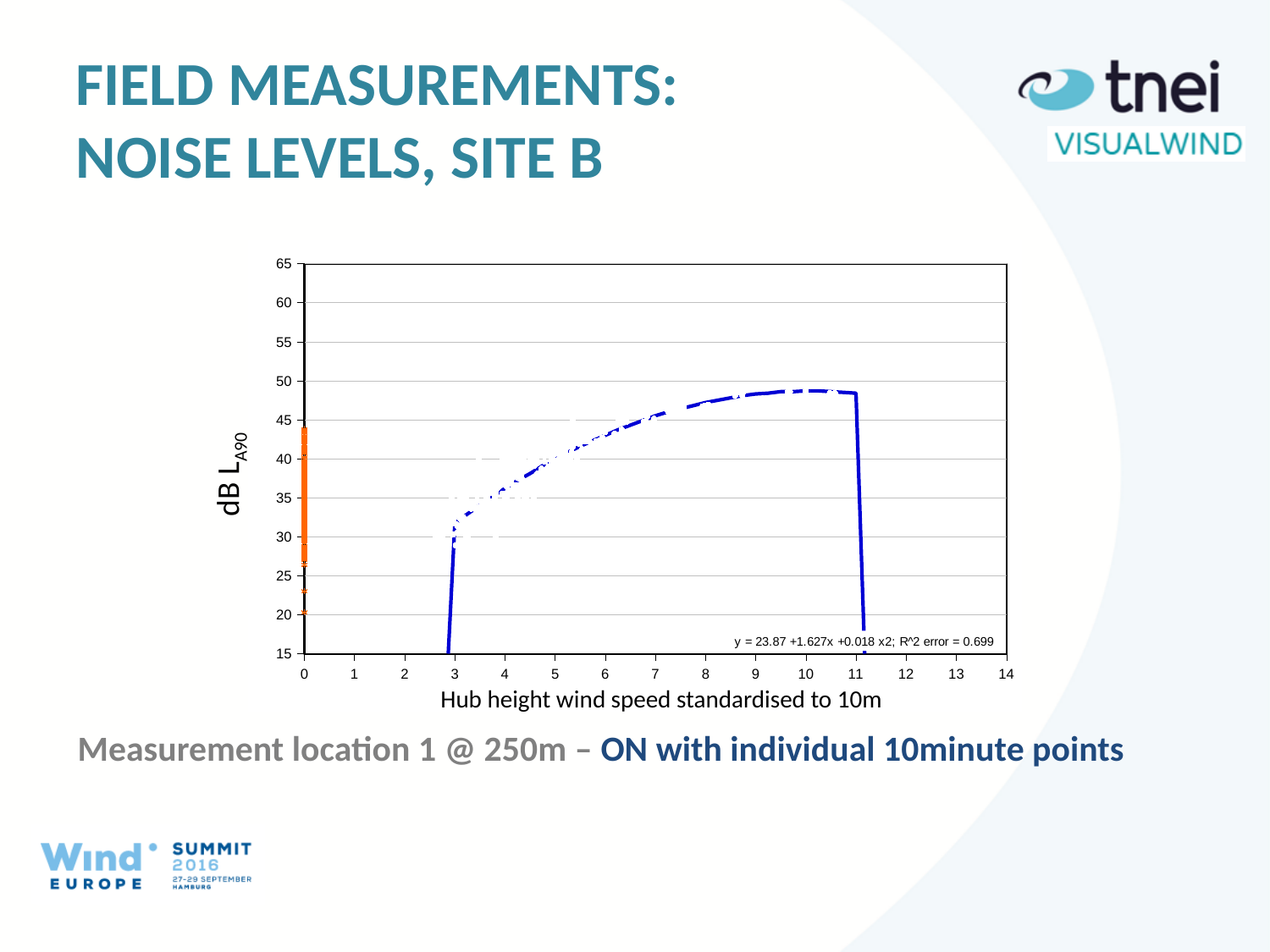
What kind of chart is shown on the slide? line chart What is the R^2 error value printed on the chart? 0.699 What is the label of the y axis? dB LA90 What is the highest value shown on the x axis? 14 What is the highest value shown on the y axis? 65 What is the lowest value shown on the y axis? 15 What is the fitted equation printed on the chart? y = 23.87 +1.627x +0.018 x2 What is the label of the x axis? Hub height wind speed standardised to 10m Does the fitted curve rise or fall as wind speed increases from 3 to 10? rise Is the fitted curve value at a wind speed of 3 greater or less than 35? less Is the fitted curve value at a wind speed of 10 greater or less than 45? greater